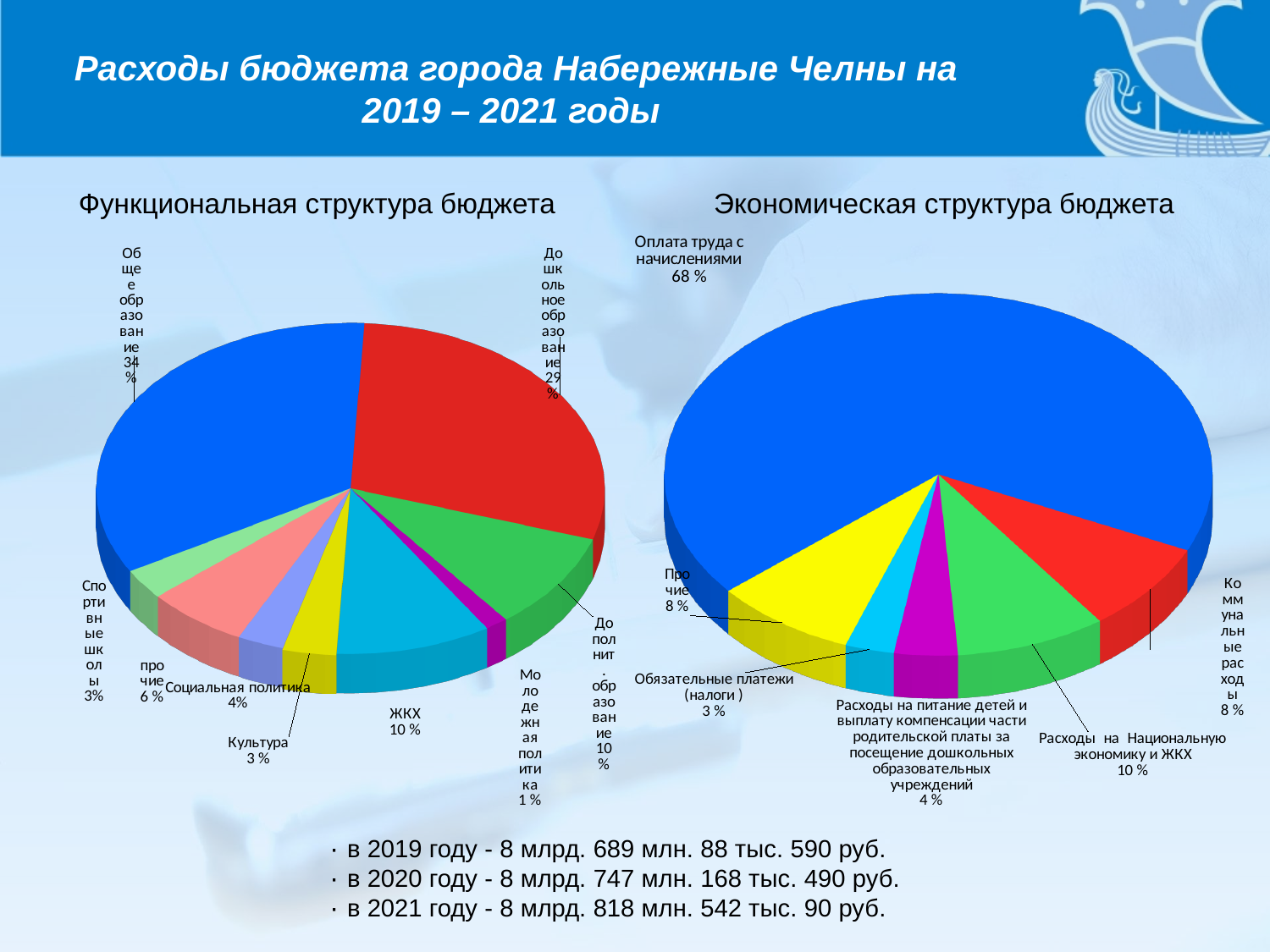
In the 'Экономическая структура бюджета' chart, what share do 'Расходы на Национальную экономику и ЖКХ' have? 10 % In the 'Экономическая структура бюджета' chart, which is larger: 'Коммунальные расходы' or 'Расходы на Национальную экономику и ЖКХ'? Расходы на Национальную экономику и ЖКХ In the 'Функциональная структура бюджета' chart, what share does 'Дошкольное образование' have? 29 % In the 'Функциональная структура бюджета' chart, what share does 'Общее образование' have? 34 % In the 'Экономическая структура бюджета' chart, which category has the smallest share? Обязательные платежи (налоги) In the 'Функциональная структура бюджета' chart, what is the difference between the shares of 'Общее образование' and 'Дошкольное образование'? 5 % How many slices does the 'Экономическая структура бюджета' pie chart have? 6 What kind of chart is used for the 'Функциональная структура бюджета' on the left? Pie chart In the 'Экономическая структура бюджета' chart, what share does 'Оплата труда с начислениями' have? 68 % How many slices does the 'Функциональная структура бюджета' pie chart have? 9 In the 'Функциональная структура бюджета' chart, which category has the smallest share? Молодежная политика In the 'Функциональная структура бюджета' chart, which category has the largest share? Общее образование